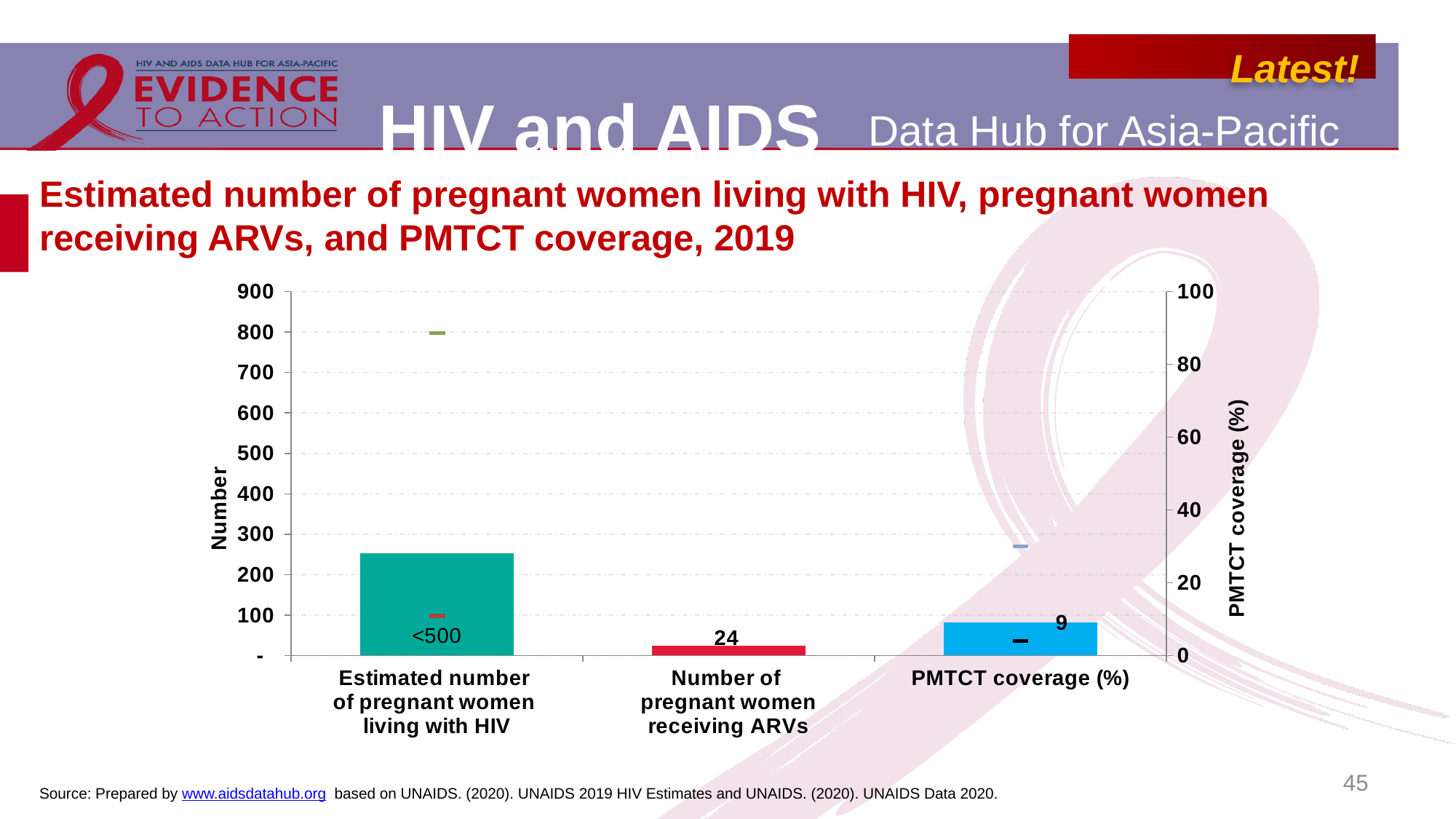
What is the data label on the bar for the estimated number of pregnant women living with HIV? <500 What is the data label on the bar for the number of pregnant women receiving ARVs? 24 How many categories are shown on the x axis of the chart? 3 Is the bar for the estimated number of pregnant women living with HIV greater or less than 200 on the left axis? greater Which category has the tallest bar in the chart? Estimated number of pregnant women living with HIV Is the bar for the estimated number of pregnant women living with HIV greater or less than 300 on the left axis? less What is the title of the right vertical axis of the chart? PMTCT coverage (%) What year does the chart title say the data refer to? 2019 What is the data label on the PMTCT coverage (%) bar? 9 What kind of chart is shown on the slide? bar chart What is the title of the left vertical axis of the chart? Number Is the bar for the number of pregnant women receiving ARVs greater or less than 100 on the left axis? less